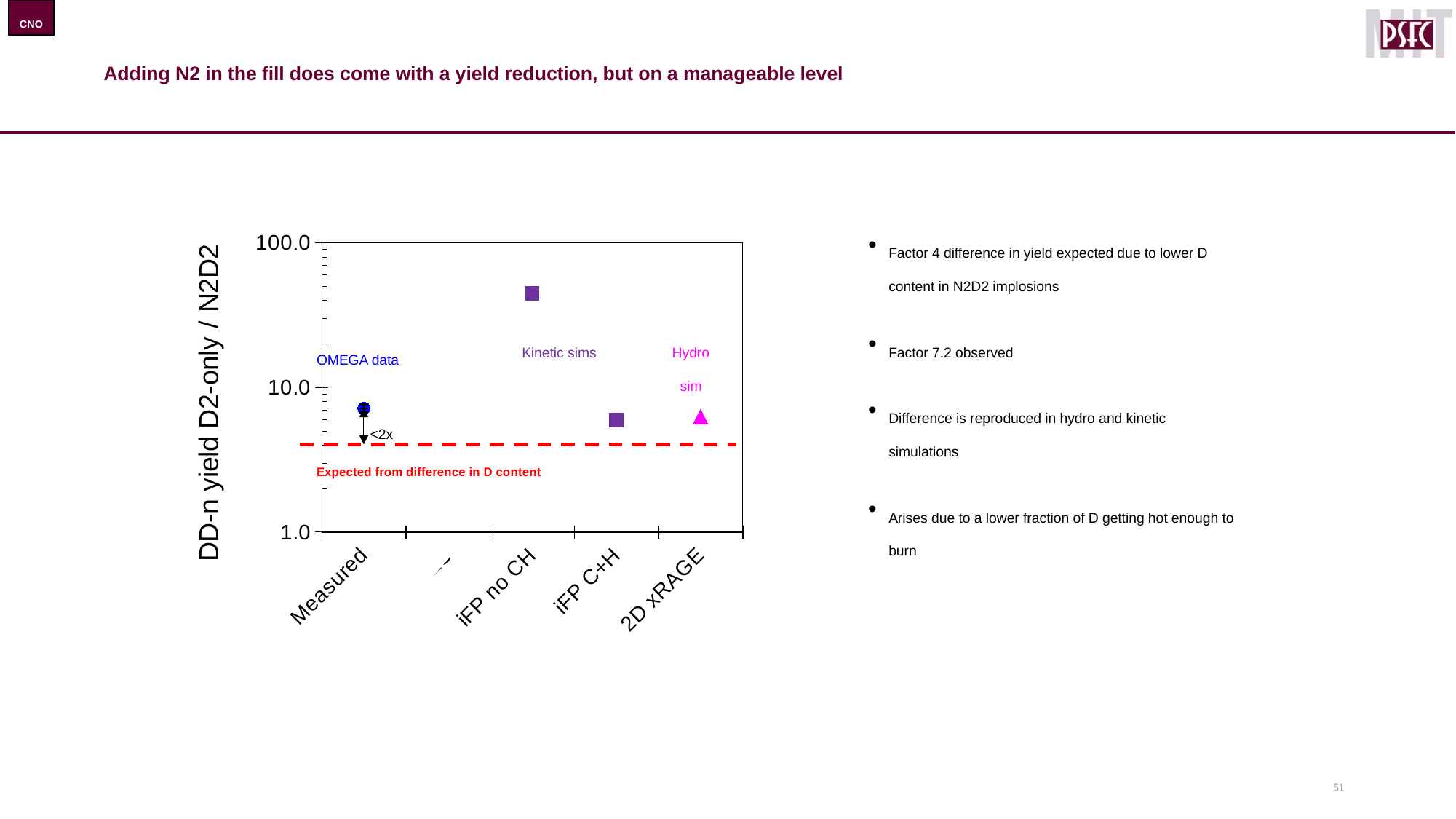
Is the value for Measured greater or less than 10.0? less What kind of chart is shown on the slide? scatter chart Is the value for iFP no CH greater or less than 10.0? greater What does the red dashed horizontal line represent, according to its label? Expected from difference in D content How many data points are plotted on the chart? 4 Which is larger, the value for iFP no CH or the value for 2D xRAGE? iFP no CH Is the value for iFP C+H greater or less than 10.0? less What is the label of the y-axis? DD-n yield D2-only / N2D2 Which is larger, the value for iFP no CH or the value for Measured? iFP no CH Which category has the highest DD-n yield D2-only / N2D2 value? iFP no CH